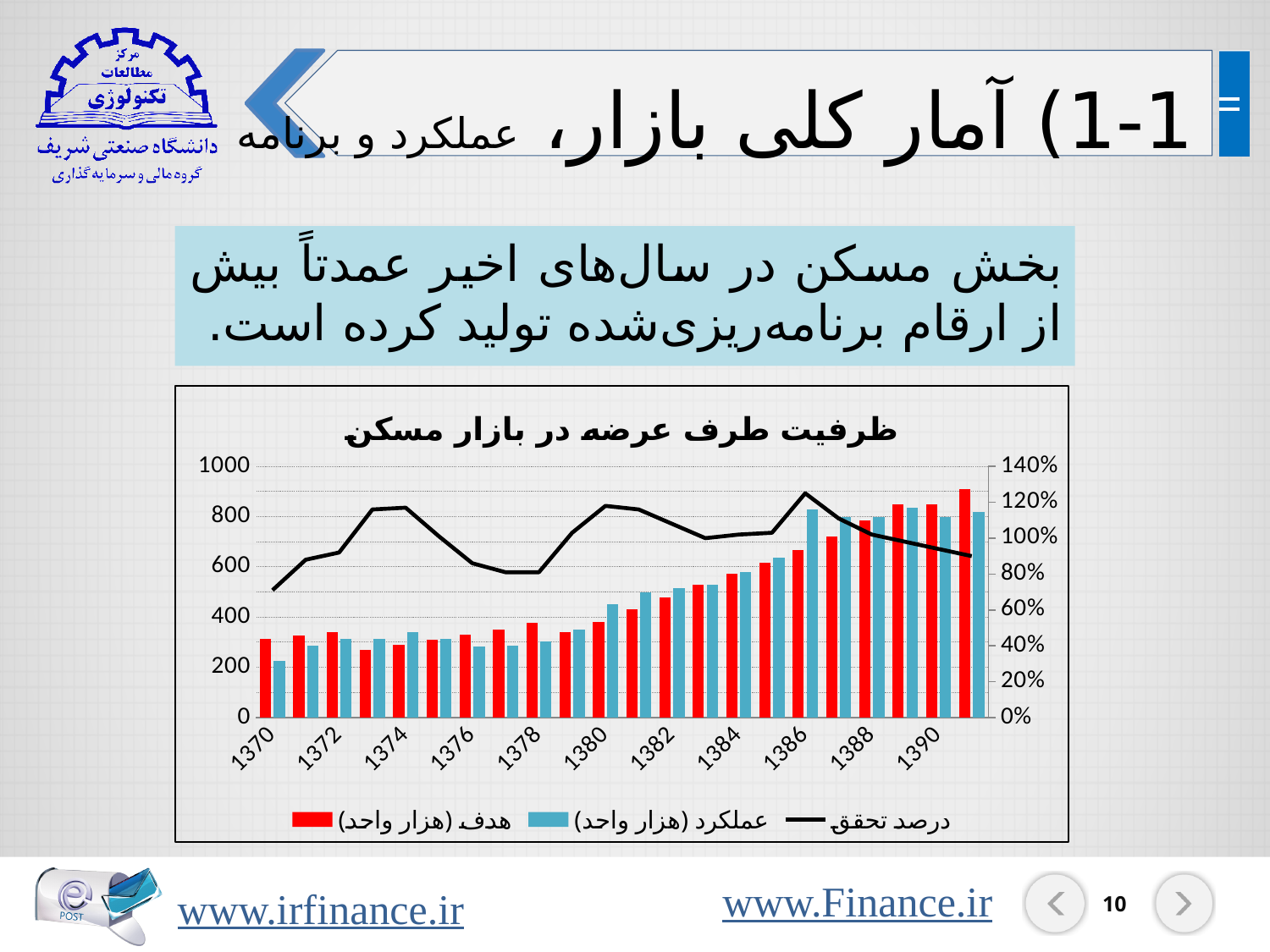
Is the درصد تحقق line value for 1378 greater or less than 100%? less What kind of chart is shown on the slide? bar chart with a line Is the value of the rightmost هدف (هزار واحد) bar greater or less than 800? greater Is the value of the هدف (هزار واحد) bar for 1370 greater or less than 200? greater Which colour represents the هدف (هزار واحد) series? red For 1386, which is larger: the هدف (هزار واحد) bar or the عملکرد (هزار واحد) bar? عملکرد (هزار واحد) How many series does the chart legend list? 3 What is the title of the chart? ظرفیت طرف عرضه در بازار مسکن For 1370, which is larger: the هدف (هزار واحد) bar or the عملکرد (هزار واحد) bar? هدف (هزار واحد) Do the هدف (هزار واحد) bars generally rise or fall from 1370 to the last year shown? rise